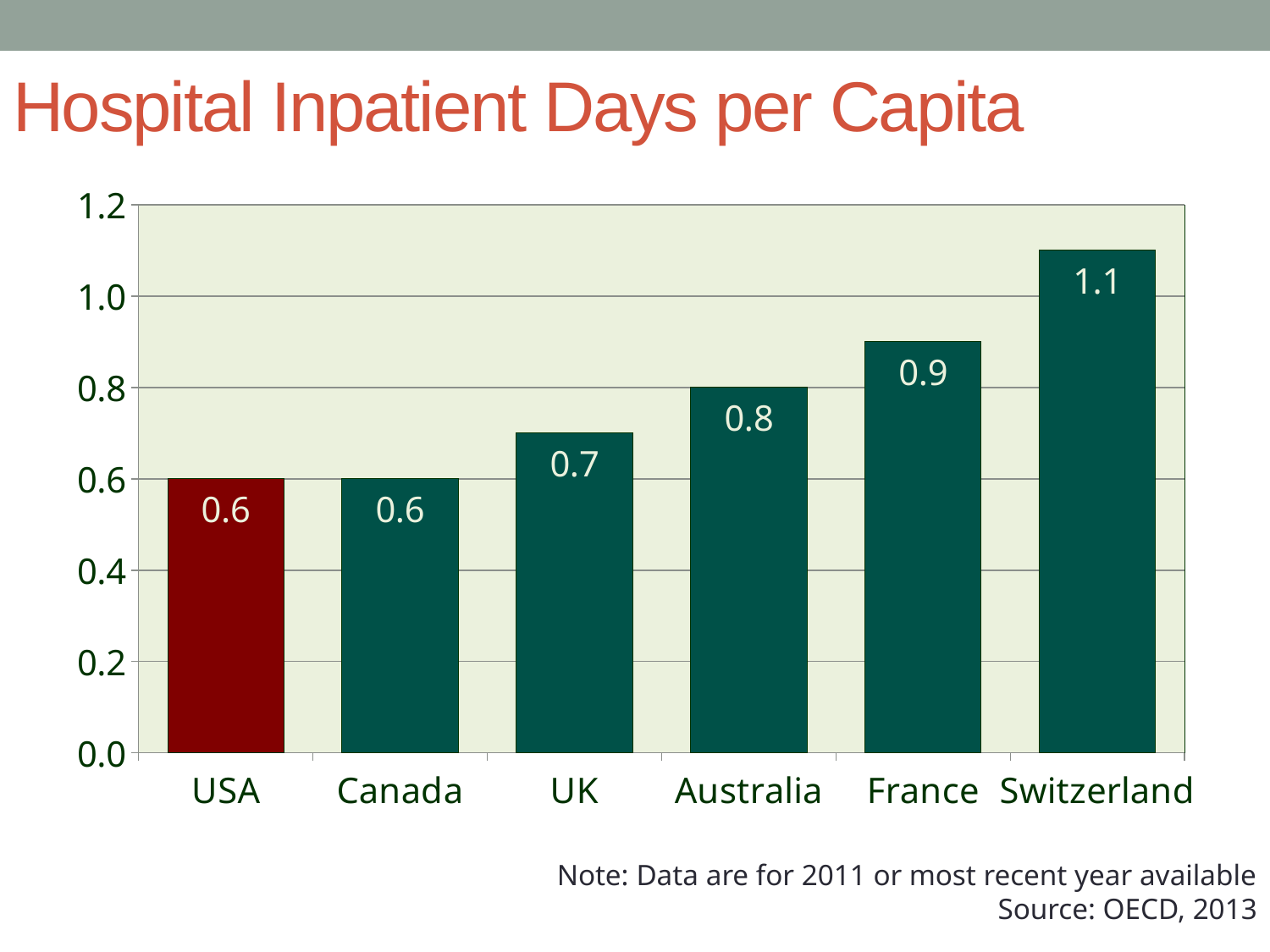
What is the difference between the values for France and the UK? 0.2 Which is larger, the value for France or the value for Australia? France What is the value for Switzerland? 1.1 Which country has the highest hospital inpatient days per capita? Switzerland Which country's bar is coloured differently from the others? USA What is the value for Australia? 0.8 How many countries are shown in the chart? 6 What is the difference between the values for Switzerland and the USA? 0.5 What is the value for the UK? 0.7 Is the value for Switzerland greater or less than 1.0? greater Do the values rise or fall from left to right across the countries? rise What kind of chart is shown on the slide? bar chart